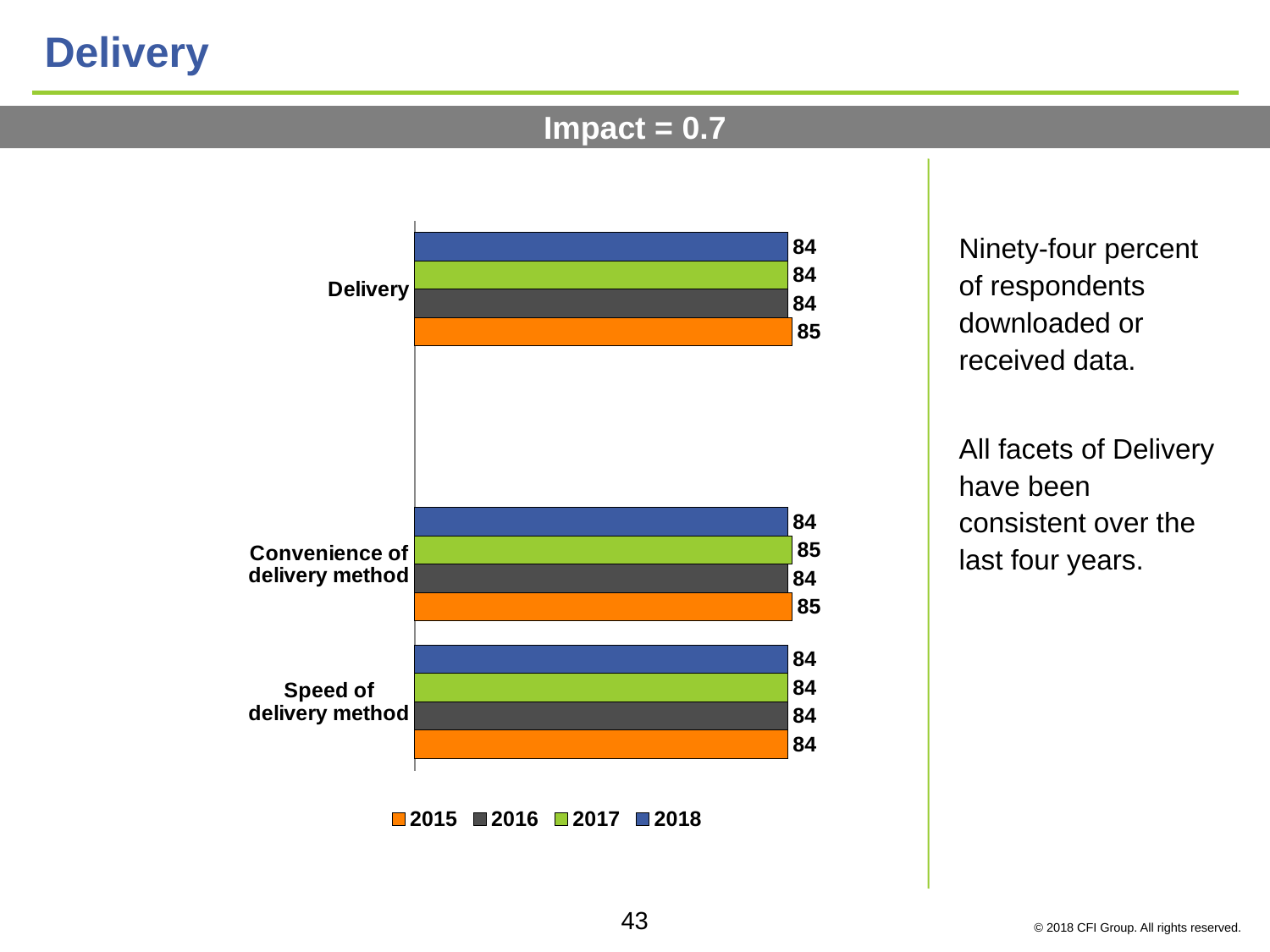
What is the value for Delivery in 2015? 85 What is the value for Delivery in 2018? 84 What colour represents 2015 in the chart? Orange How many series does the legend list? 4 What is the value for Convenience of delivery method in 2016? 84 What is the difference between the 2015 and 2018 values for Delivery? 1 Which is larger for Convenience of delivery method, the 2017 value or the 2018 value? 2017 What kind of chart is shown on the slide? Bar chart What is the value for Convenience of delivery method in 2017? 85 What is the value for Speed of delivery method in 2018? 84 Which years are listed in the chart legend? 2015, 2016, 2017, 2018 How many categories are shown on the chart? 3